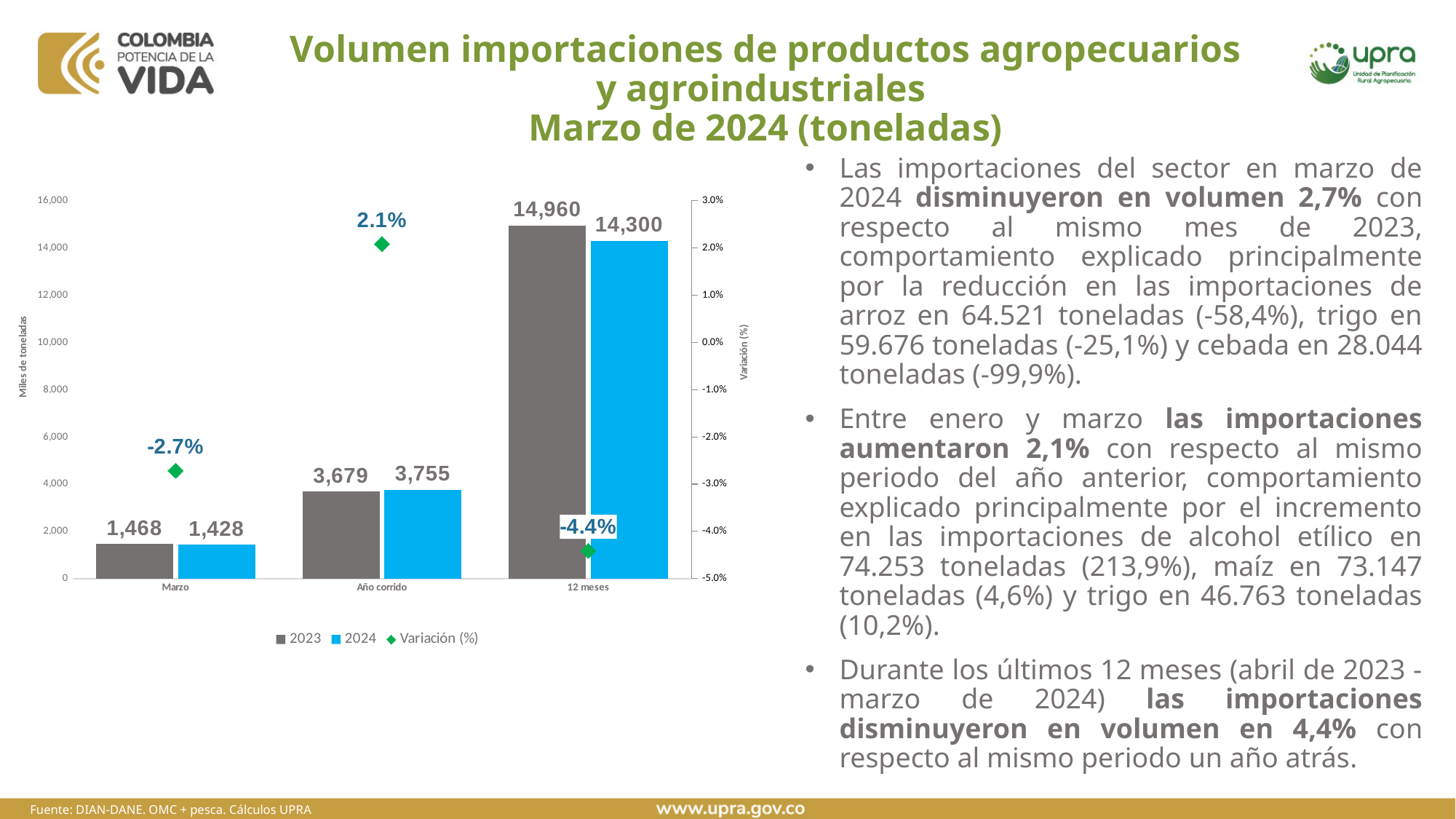
What is the difference between the 2023 and 2024 values for 12 meses? 660 How many categories are shown on the x axis? 3 What kind of chart is used for the 2023 and 2024 series? Bar chart What is the Variación (%) value for Año corrido? 2.1% Which category has the lowest 2024 value? Marzo What is the 2024 value for Año corrido? 3,755 Which is larger for Año corrido, the 2023 value or the 2024 value? 2024 Which category has the highest 2023 value? 12 meses What is the 2024 value for 12 meses? 14,300 What is the Variación (%) value for Marzo? -2.7% How many series does the legend list? 3 What is the 2023 value for Marzo? 1,468